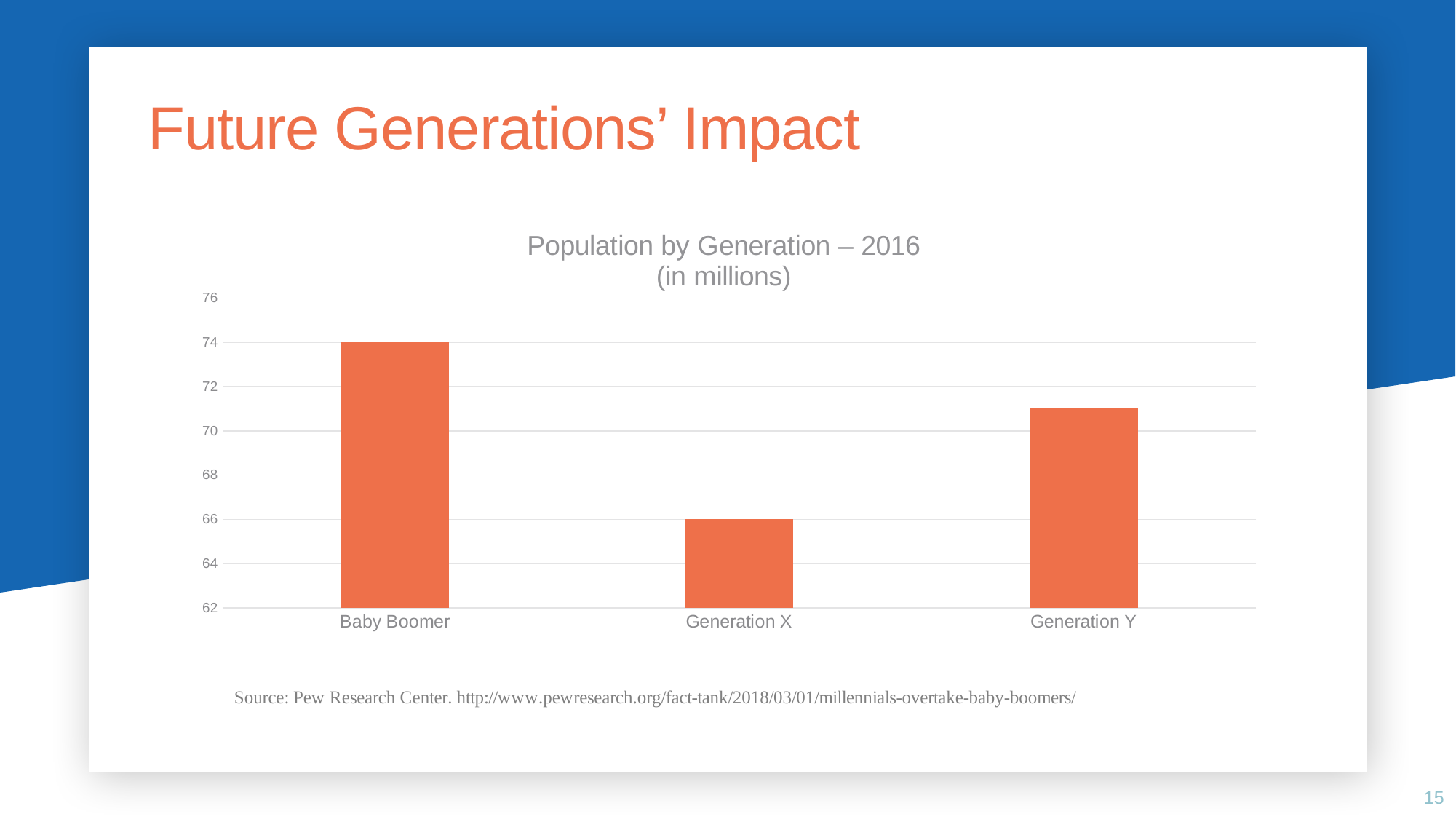
Which generation has the lowest population in the chart? Generation X What is the value for Generation X in the Population by Generation – 2016 chart? 66 What is the value for Baby Boomer in the Population by Generation – 2016 chart? 74 Is the value for Generation Y greater or less than 72? less What is the highest value shown on the vertical axis of the chart? 76 Is the value for Generation Y greater or less than 70? greater What is the title of the chart? Population by Generation – 2016 (in millions) Which generation has the highest population in the chart? Baby Boomer What is the difference between the Baby Boomer and Generation X values? 8 Which is larger, the value for Generation Y or the value for Generation X? Generation Y How many generations are shown in the chart? 3 What kind of chart is shown on the slide? Bar chart